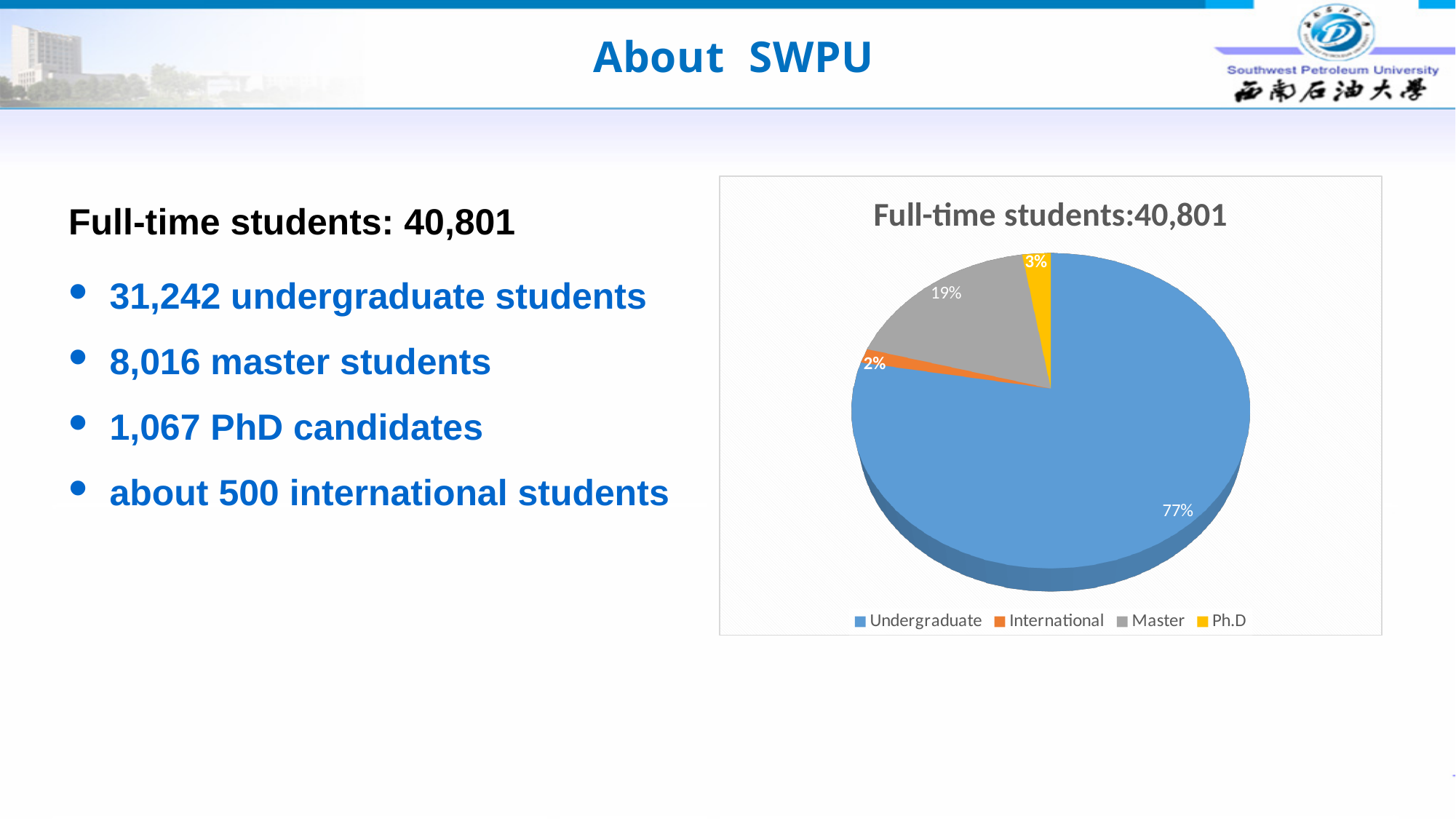
What is the difference in percentage points between the Undergraduate slice and the Master slice? 58 What percentage of the pie does the Ph.D slice represent? 3% What is the title of the chart? Full-time students:40,801 What percentage of the pie does the Undergraduate slice represent? 77% What type of chart is shown on the slide? pie chart How many categories does the pie chart show? 4 Which category has the smallest slice of the pie? International What percentage of the pie does the International slice represent? 2% Which is larger, the Master slice or the Ph.D slice? Master What colour is the Master slice in the pie chart? grey Which category has the largest slice of the pie? Undergraduate